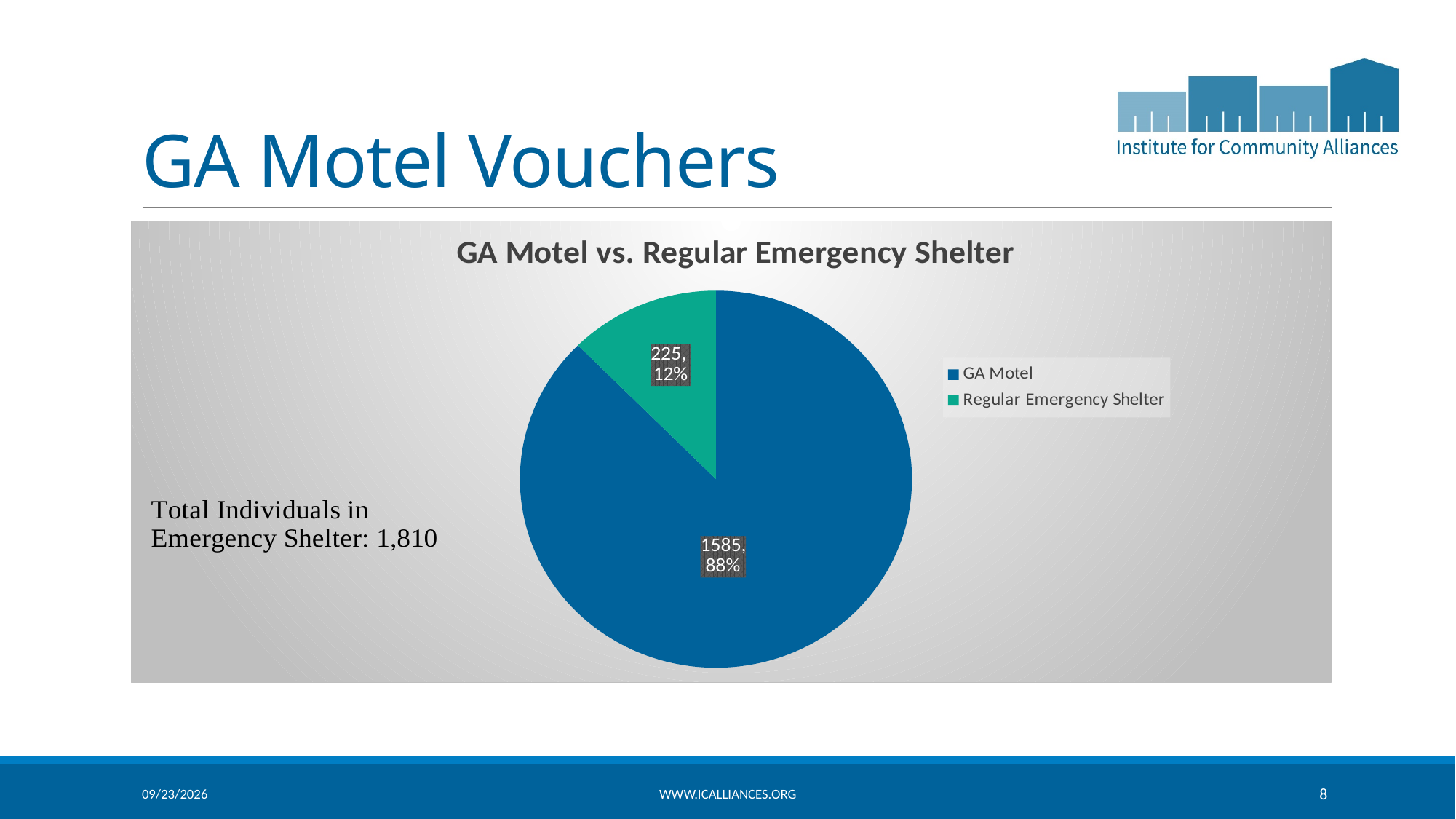
What is the title of the chart? GA Motel vs. Regular Emergency Shelter What share of the pie does Regular Emergency Shelter represent? 12% What is the value for Regular Emergency Shelter? 225 Which category has the largest slice? GA Motel How many entries does the legend list? 2 How many slices does the pie chart have? 2 What share of the pie does GA Motel represent? 88% What is the value for GA Motel? 1585 What is the difference between the GA Motel value and the Regular Emergency Shelter value? 1360 Which colour represents Regular Emergency Shelter in the pie chart? green Which category has the smallest slice? Regular Emergency Shelter What type of chart is shown on the slide? pie chart